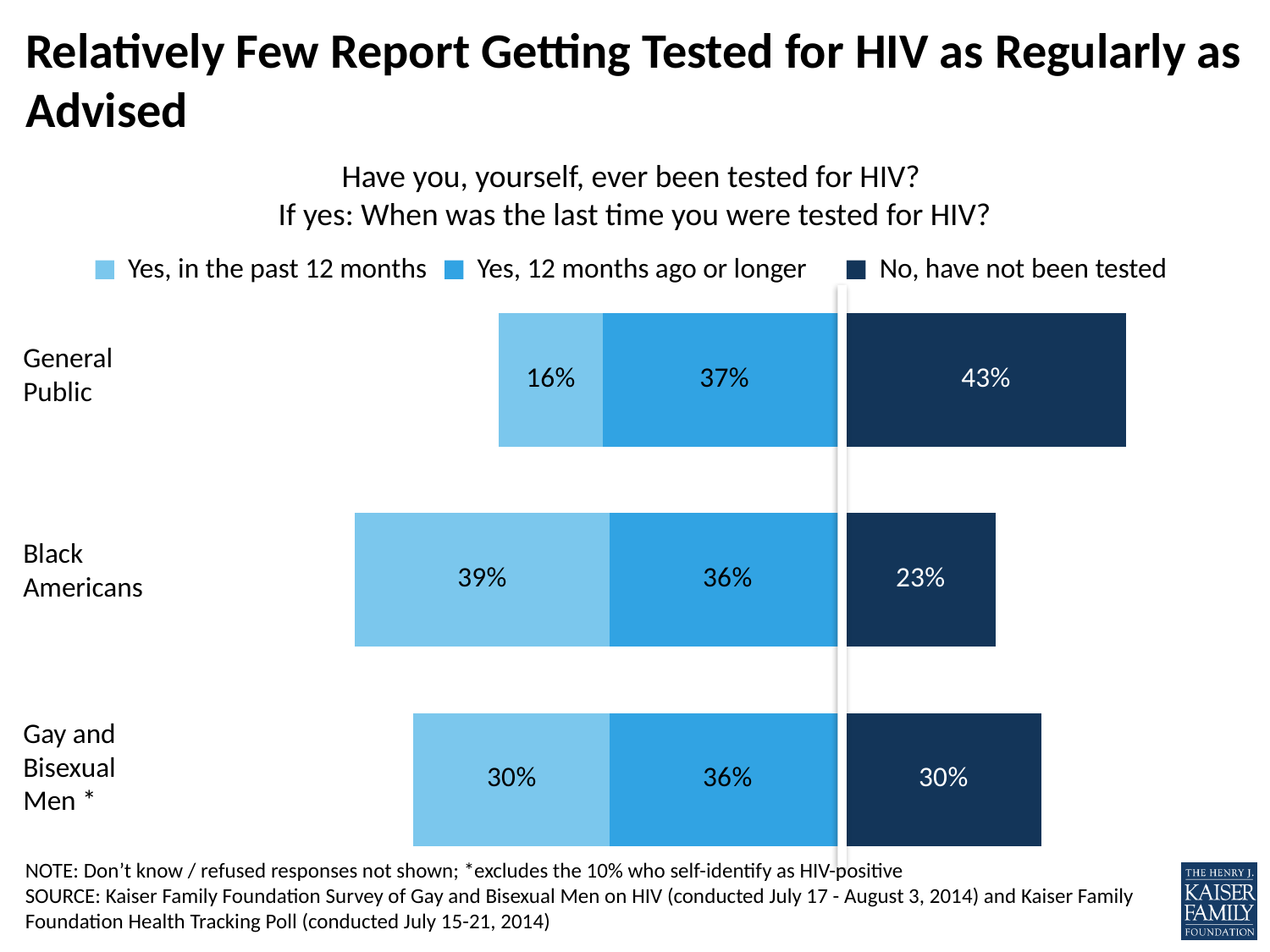
Which group has the lowest share tested for HIV in the past 12 months? General Public What kind of chart is shown on the slide? Stacked bar chart Which is larger: the share of Gay and Bisexual Men not tested, or the share of Black Americans not tested? Gay and Bisexual Men How many percentage points higher is the 'Yes, in the past 12 months' share for Black Americans than for the General Public? 23 percentage points Which group has the highest share saying they have not been tested for HIV? General Public What percentage of Gay and Bisexual Men say they were tested 12 months ago or longer? 36% How many response categories does the legend list? 3 What percentage of the General Public say they have not been tested for HIV? 43% Which legend entry is shown in the darkest blue colour? No, have not been tested What percentage of Black Americans were tested for HIV in the past 12 months? 39% How many groups are shown in the chart? 3 What is the total of the three labelled segments for the Black Americans bar? 98%